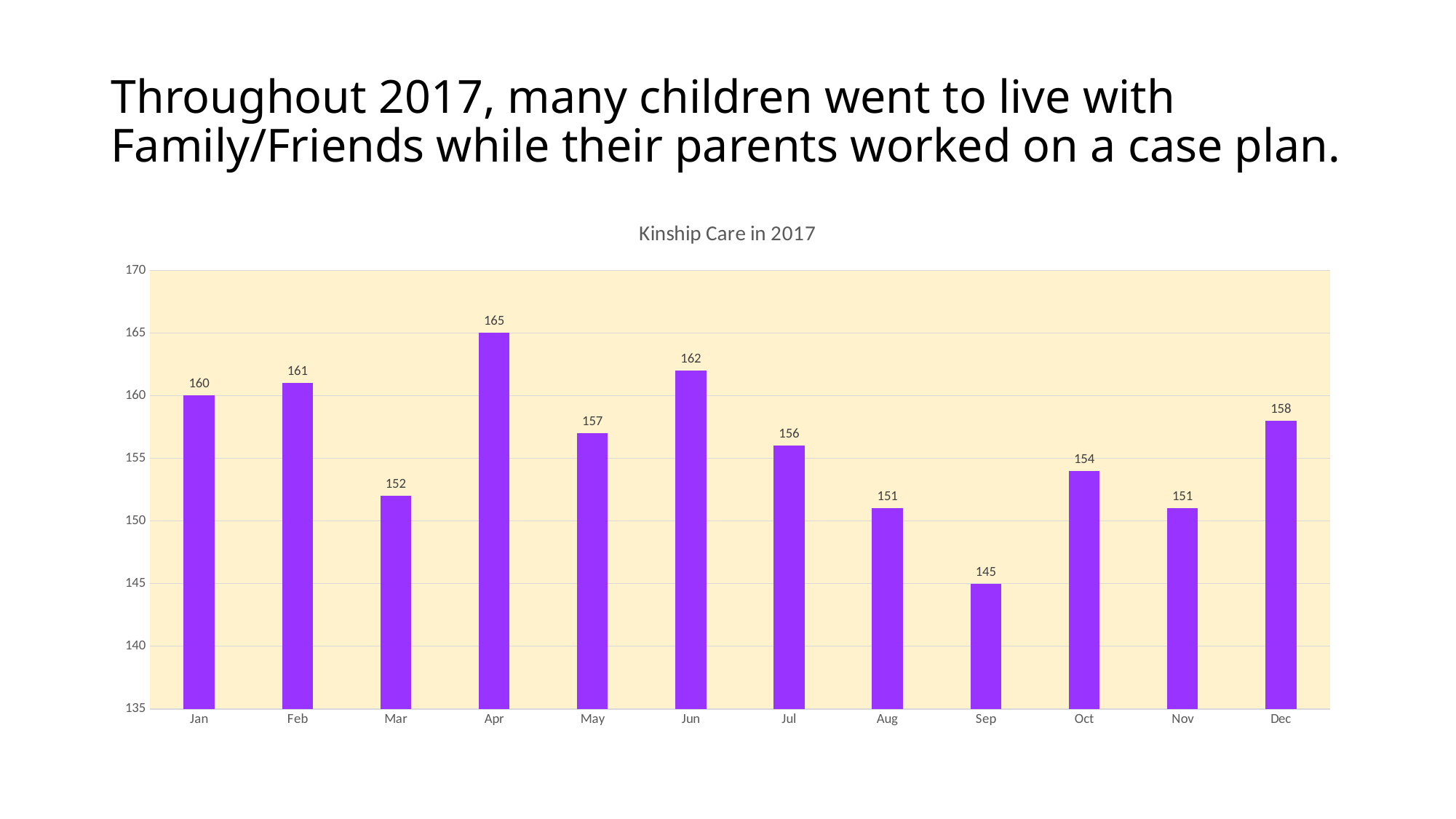
What is the title of the chart on the slide? Kinship Care in 2017 What is the value for Dec in the Kinship Care in 2017 chart? 158 Which is larger in the Kinship Care in 2017 chart, the value for Jun or the value for Oct? Jun Is the value for Jul in the Kinship Care in 2017 chart greater or less than 150? greater Which month has the highest value in the Kinship Care in 2017 chart? Apr What is the difference between the values for Jan and Mar in the Kinship Care in 2017 chart? 8 What is the value for Sep in the Kinship Care in 2017 chart? 145 What kind of chart is the Kinship Care in 2017 chart? Bar chart How many months are shown in the Kinship Care in 2017 chart? 12 What is the value for Apr in the Kinship Care in 2017 chart? 165 What is the difference between the values for Apr and Sep in the Kinship Care in 2017 chart? 20 Which month has the lowest value in the Kinship Care in 2017 chart? Sep